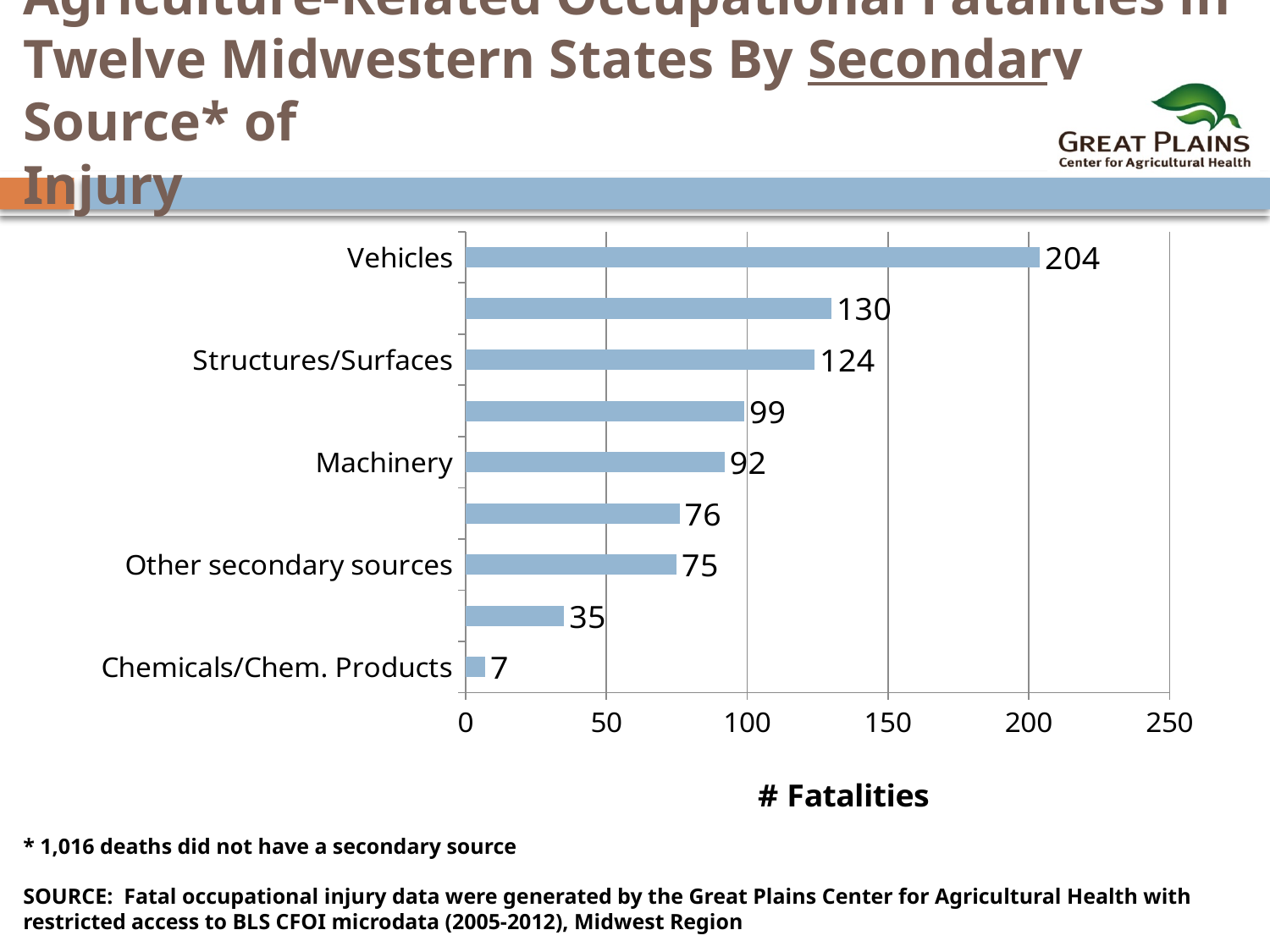
What is the number of fatalities for Chemicals/Chem. Products? 7 What is the number of fatalities for Other secondary sources? 75 Is the value for Structures/Surfaces greater or less than 100? greater What type of chart is shown on the slide? Bar chart What is the number of fatalities for Vehicles? 204 Which has more fatalities, Machinery or Other secondary sources? Machinery How many bars are plotted in the chart? 9 Which secondary source has the highest number of fatalities? Vehicles What is the difference in fatalities between Vehicles and Structures/Surfaces? 80 What is the number of fatalities for Structures/Surfaces? 124 Which secondary source has the lowest number of fatalities? Chemicals/Chem. Products What is the number of fatalities for Machinery? 92